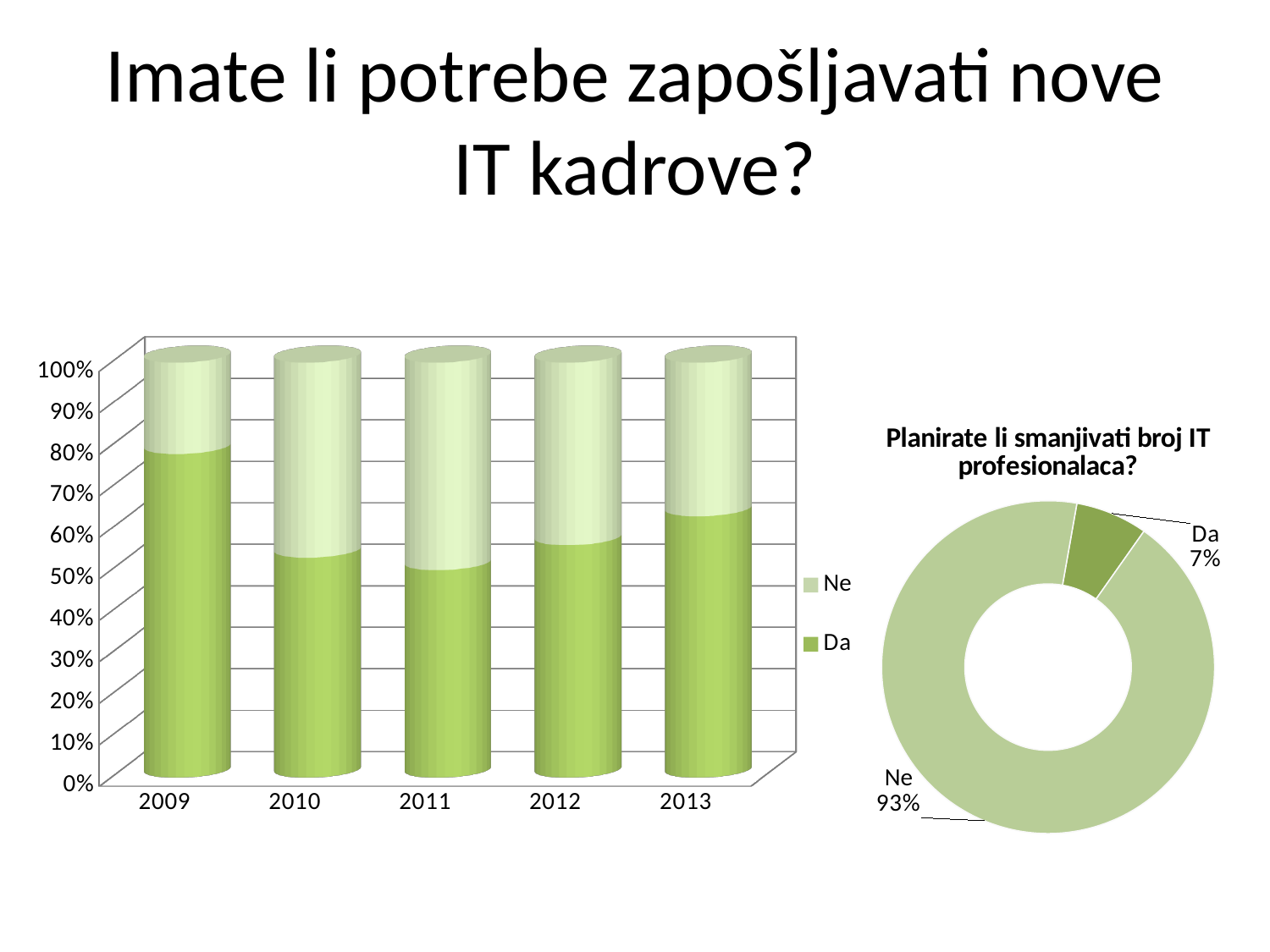
In the chart titled "Planirate li smanjivati broj IT profesionalaca?", what is the difference in percentage points between "Ne" and "Da"? 86 percentage points How many series does the legend of the left bar chart list? 2 In the left bar chart, is the "Da" value for 2009 greater or less than 70%? greater In the chart titled "Planirate li smanjivati broj IT profesionalaca?", what percentage answered "Ne"? 93% What kind of chart is the left chart on the slide? Stacked bar chart In the left bar chart, which year has the highest share of "Da" responses? 2009 In the left bar chart, is the "Da" share larger in 2009 or in 2011? 2009 In the left bar chart, is the "Da" value for 2011 greater or less than 60%? less What kind of chart is the right chart on the slide? Doughnut chart In the chart titled "Planirate li smanjivati broj IT profesionalaca?", what percentage answered "Da"? 7% In the left bar chart, is the "Da" value for 2013 greater or less than 50%? greater How many years are shown on the x axis of the left bar chart? 5